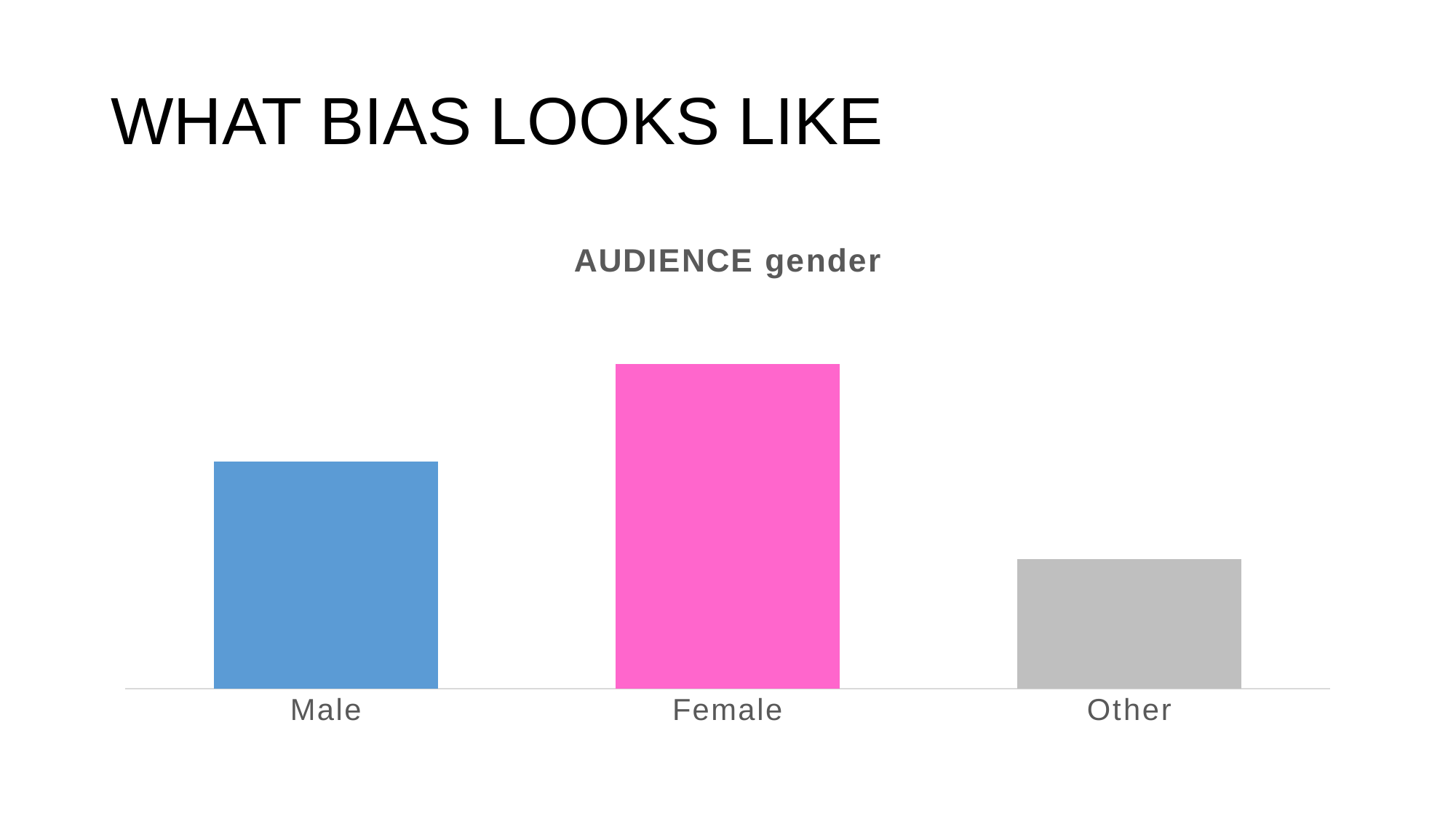
Which category has the highest bar in the chart? Female Which bar is taller, Male or Female? Female Which bar is shorter, Female or Other? Other What colour is the bar for Female? pink Which bar is taller, Male or Other? Male What are the three category labels on the x axis, from left to right? Male, Female, Other Which category has the lowest bar in the chart? Other What kind of chart is shown on the slide? bar chart How many categories are shown on the x axis of the chart? 3 What is the title of the chart? AUDIENCE gender